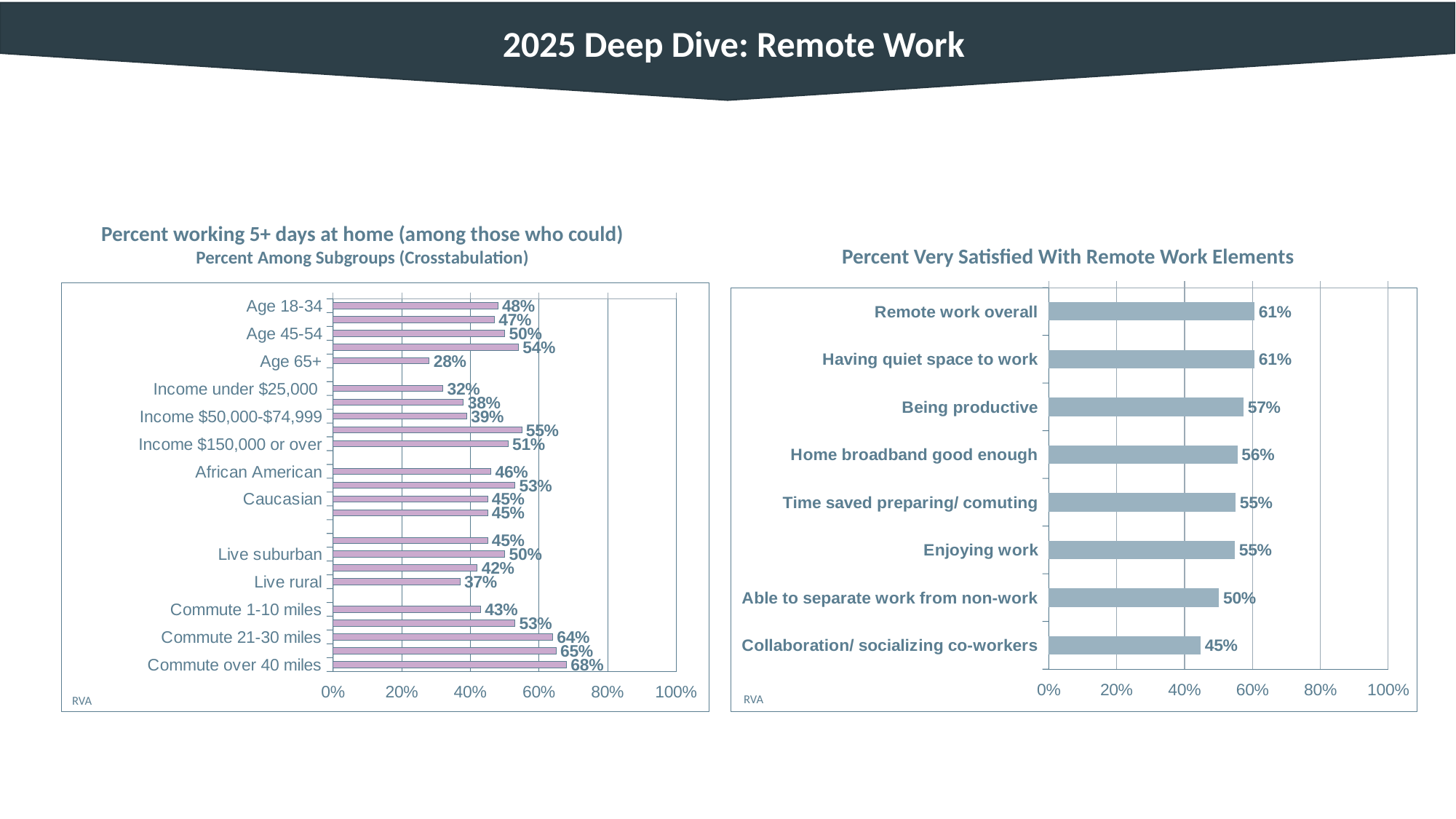
In the 'Percent Very Satisfied With Remote Work Elements' chart, which element has the lowest value? Collaboration/ socializing co-workers In the 'Percent Very Satisfied With Remote Work Elements' chart, what is the value for Being productive? 57% In the 'Percent Very Satisfied With Remote Work Elements' chart, how many elements are listed? 8 In the 'Percent working 5+ days at home' chart, is the value for Age 45-54 greater or less than 40%? greater In the 'Percent Very Satisfied With Remote Work Elements' chart, what is the value for Able to separate work from non-work? 50% In the 'Percent working 5+ days at home' chart, what is the value for Live rural? 37% In the 'Percent working 5+ days at home' chart, what is the value for Age 65+? 28% In the 'Percent working 5+ days at home' chart, what is the difference between Commute 21-30 miles and Commute 1-10 miles? 21% In the 'Percent working 5+ days at home' chart, what is the value for Commute over 40 miles? 68% In the 'Percent working 5+ days at home' chart, which is larger: Income under $25,000 or Income $150,000 or over? Income $150,000 or over In the 'Percent Very Satisfied With Remote Work Elements' chart, what is the difference between Remote work overall and Collaboration/ socializing co-workers? 16% What kind of chart is 'Percent Very Satisfied With Remote Work Elements'? Bar chart